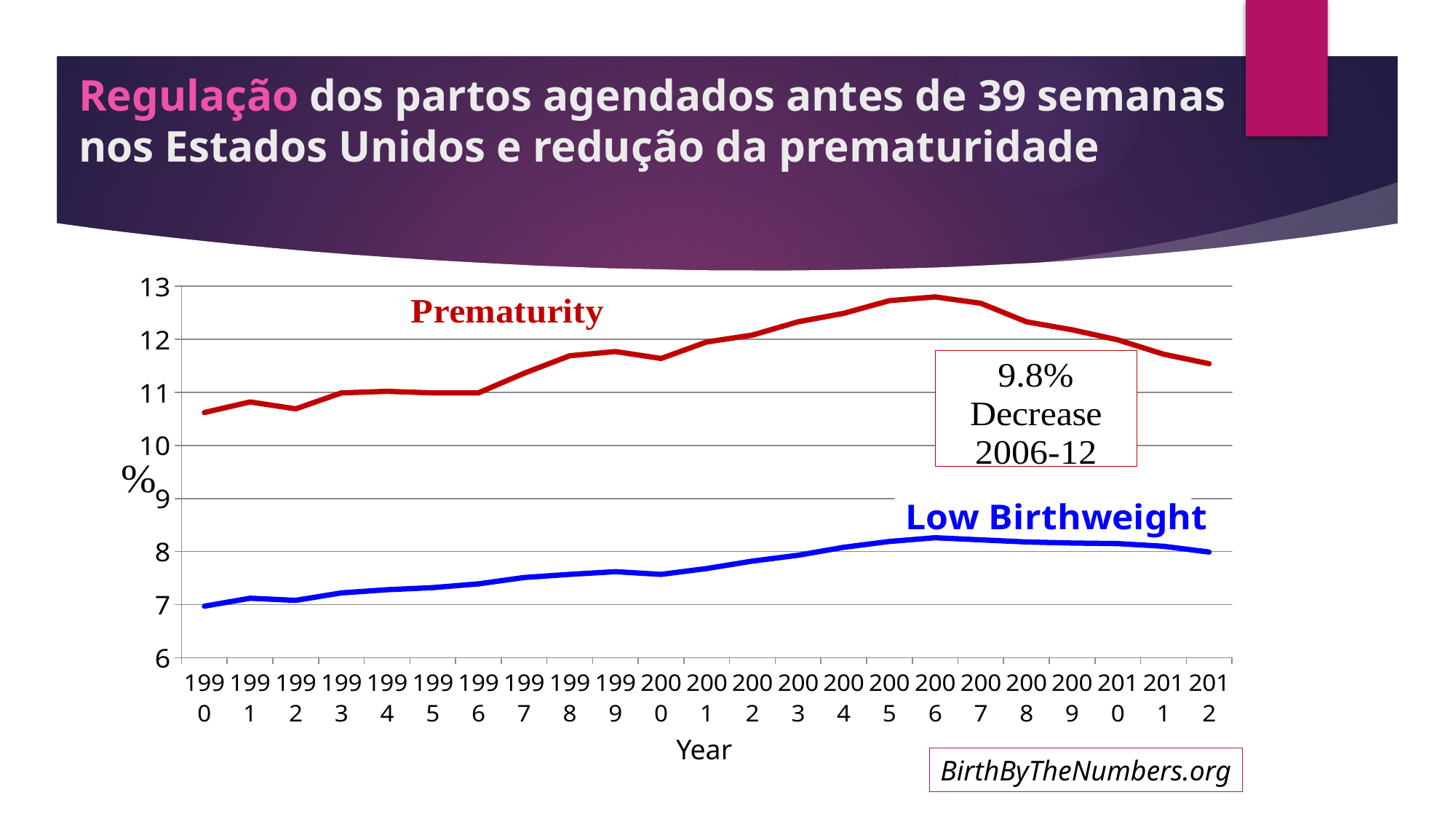
In which year does the Prematurity line reach its highest value? 2006 Does the Prematurity line rise or fall from 2006 to 2012? fall How many years are shown along the x axis of the chart? 23 In 2006, which series has the larger value, Prematurity or Low Birthweight? Prematurity What decrease does the text box on the chart report for 2006-12? 9.8% Is the Prematurity value for 2006 greater or less than 12? greater Is the Prematurity value for 1990 greater or less than 11? less Is the Prematurity value for 2000 greater or less than 12? less What kind of chart is shown on the slide? line chart How many series are plotted on the chart? 2